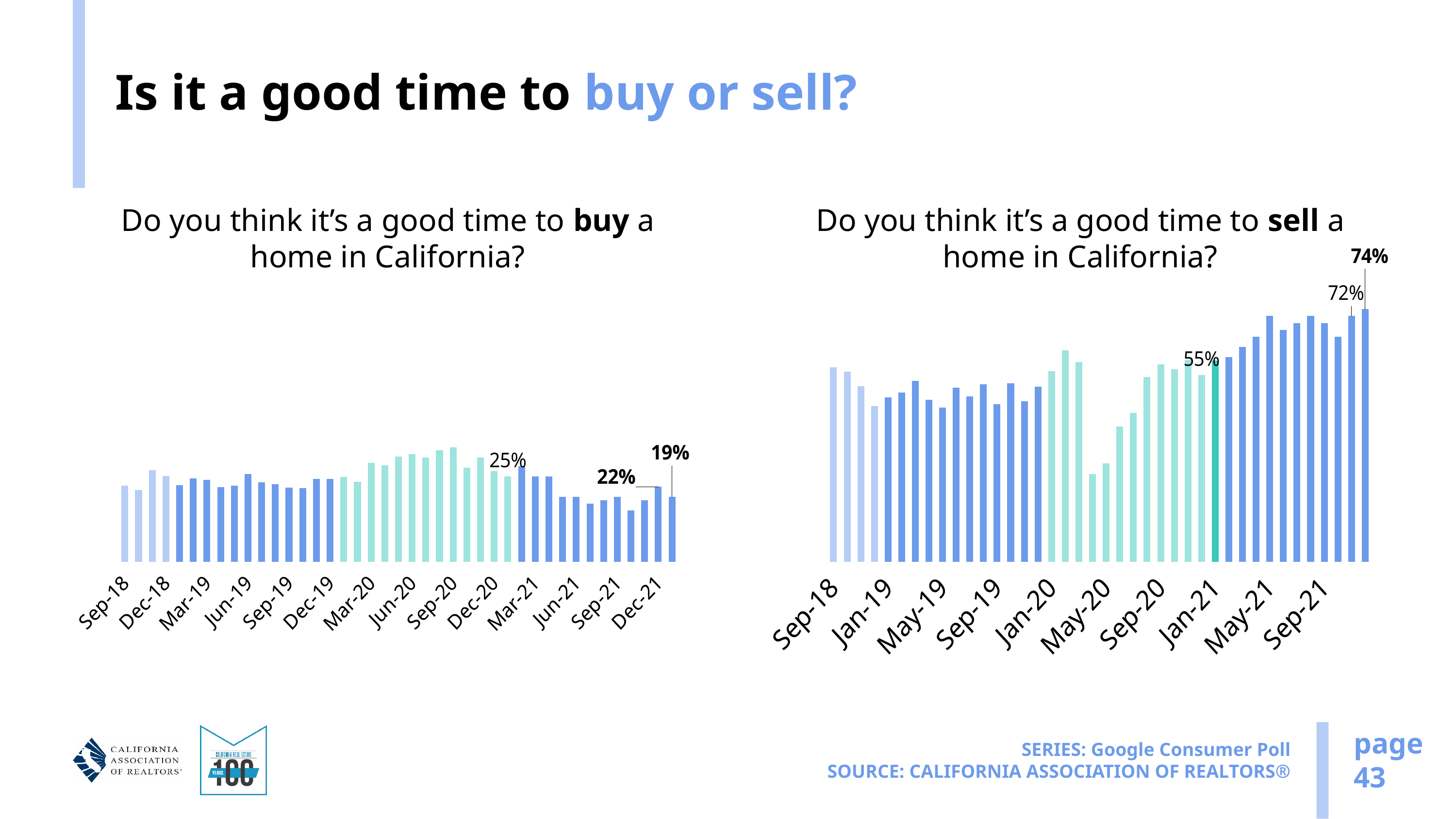
In the 'good time to buy' chart on the left, what value is labelled on the final bar (Dec-21)? 19% In the 'good time to sell' chart on the right, what value is labelled on the highlighted teal bar at Jan-21? 55% In the 'good time to buy' chart on the left, what is the difference between the labelled 22% and 19% values on the last two bars? 3 percentage points In the 'good time to buy' chart on the left, what value is labelled on the bar immediately before the final Dec-21 bar? 22% In the 'good time to sell' chart on the right, what value is labelled on the final bar (Dec-21)? 74% What is the title of the slide containing these two charts? Is it a good time to buy or sell? In the 'good time to sell' chart on the right, what value is labelled on the bar immediately before the final Dec-21 bar? 72% What kind of chart is used on the left to show whether it is a good time to buy a home in California? bar chart For Dec-21, which is larger: the share saying it is a good time to buy (left chart) or the share saying it is a good time to sell (right chart)? good time to sell In the 'good time to sell' chart on the right, which bar is the highest? Dec-21 In the 'good time to sell' chart on the right, what is the difference between the labelled 74% and 72% values on the last two bars? 2 percentage points In the 'good time to sell' chart on the right, do the values generally rise or fall from Sep-18 to Dec-21? rise